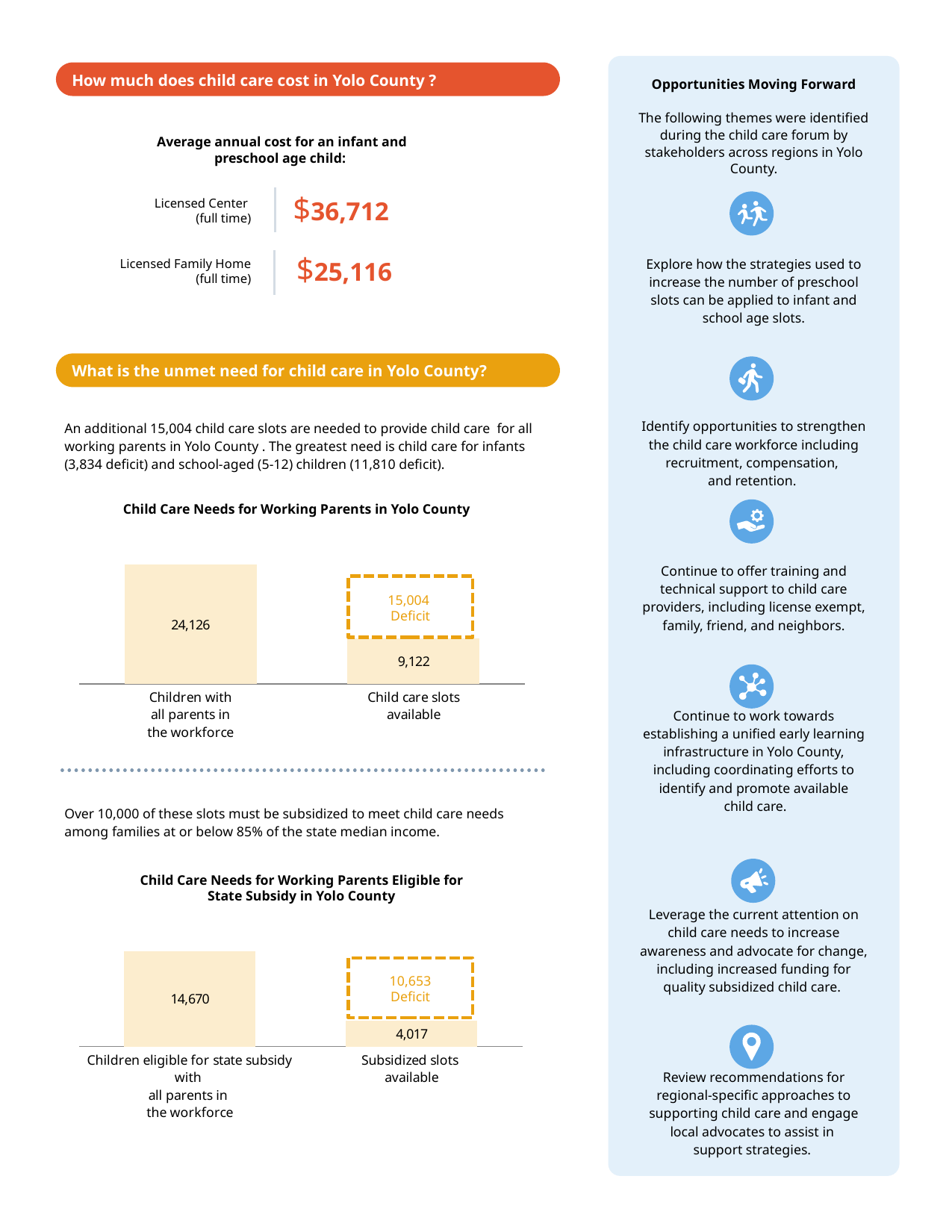
In the chart 'Child Care Needs for Working Parents in Yolo County', how many child care slots are available? 9,122 In the chart 'Child Care Needs for Working Parents in Yolo County', what is the difference between children with all parents in the workforce and child care slots available? 15,004 In the chart 'Child Care Needs for Working Parents in Yolo County', which category has the higher value? Children with all parents in the workforce How many bars does the chart 'Child Care Needs for Working Parents Eligible for State Subsidy in Yolo County' show? 2 In the chart 'Child Care Needs for Working Parents Eligible for State Subsidy in Yolo County', which category has the lower value? Subsidized slots available In the chart 'Child Care Needs for Working Parents Eligible for State Subsidy in Yolo County', what deficit is shown in the dashed box? 10,653 In the chart 'Child Care Needs for Working Parents Eligible for State Subsidy in Yolo County', what is the difference between children eligible for state subsidy and subsidized slots available? 10,653 What kind of chart is 'Child Care Needs for Working Parents in Yolo County'? Bar chart In the chart 'Child Care Needs for Working Parents Eligible for State Subsidy in Yolo County', how many subsidized slots are available? 4,017 In the chart 'Child Care Needs for Working Parents in Yolo County', what deficit is shown in the dashed box? 15,004 In the chart 'Child Care Needs for Working Parents Eligible for State Subsidy in Yolo County', what is the value for children eligible for state subsidy with all parents in the workforce? 14,670 In the chart 'Child Care Needs for Working Parents in Yolo County', what is the value for children with all parents in the workforce? 24,126